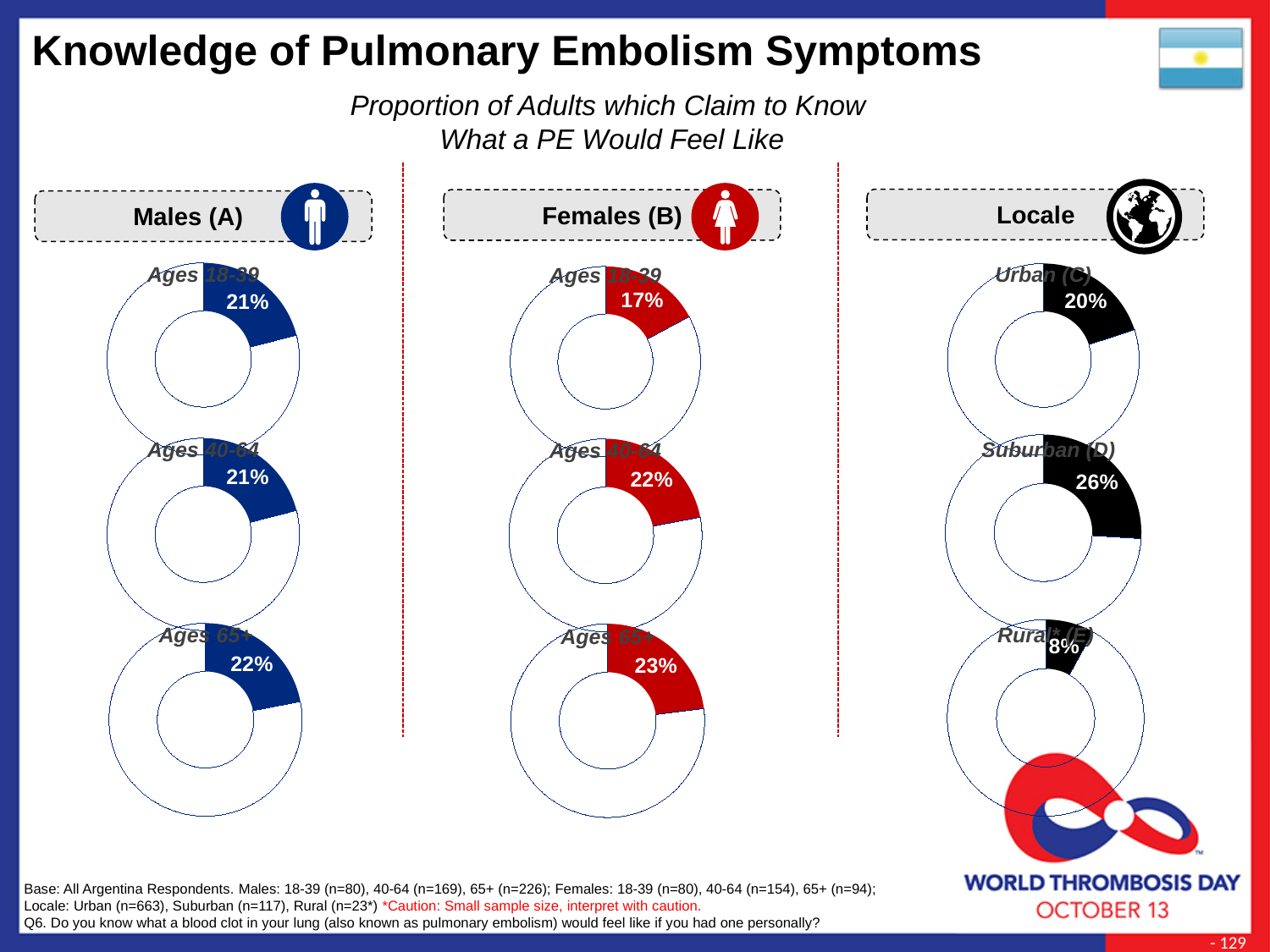
Among the three Locale donut charts, which category has the highest value? Suburban (D) What is the difference between the Suburban (D) value and the Rural (E) value in the Locale group? 18% In the Locale group, what is the value shown for Suburban (D)? 26% What is the difference between the Females (B) Ages 65+ value and the Females (B) Ages 18-39 value? 6% In the Males (A) group, what is the value shown for Ages 65+? 22% In the Females (B) group, what proportion of adults aged 18-39 claim to know what a PE would feel like? 17% In the Males (A) group, what proportion of adults aged 18-39 claim to know what a PE would feel like? 21% What type of chart is used to show each proportion on this slide? Donut (pie) chart Among the three Females (B) donut charts, which age group has the lowest value? Ages 18-39 For Ages 18-39, which is larger: the Males (A) value or the Females (B) value? Males (A) Among the three Locale donut charts, which category has the lowest value? Rural (E) In the Locale group, what is the value shown for Rural (E)? 8%